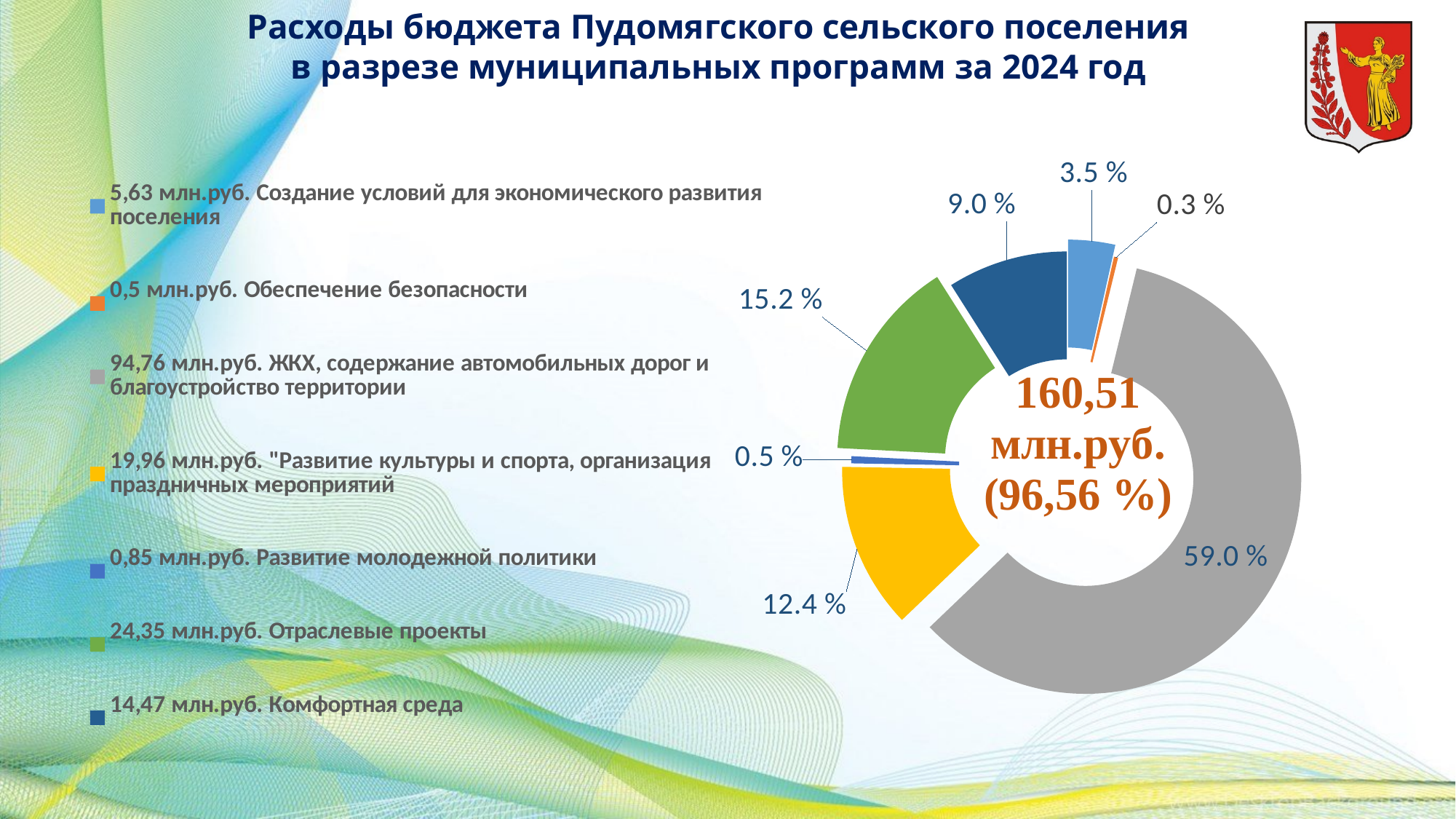
What share of the chart does the green slice (Отраслевые проекты) represent? 15.2 % What share of the chart does the light blue slice (Создание условий для экономического развития поселения) represent? 3.5 % What kind of chart is shown on the slide? Donut (pie) chart Which category has the largest share of the chart? ЖКХ, содержание автомобильных дорог и благоустройство территории What amount in млн.руб. is listed in the legend for Отраслевые проекты? 24,35 млн.руб. Which category has the smallest share of the chart? Обеспечение безопасности Which is larger: the share for Отраслевые проекты or the share for Комфортная среда? Отраслевые проекты What share of the chart does the yellow slice (Развитие культуры и спорта, организация праздничных мероприятий) represent? 12.4 % How many categories does the legend of the chart list? 7 What amount in млн.руб. is listed in the legend for Комфортная среда? 14,47 млн.руб. What total amount is printed in the centre of the donut chart? 160,51 млн.руб. (96,56 %)